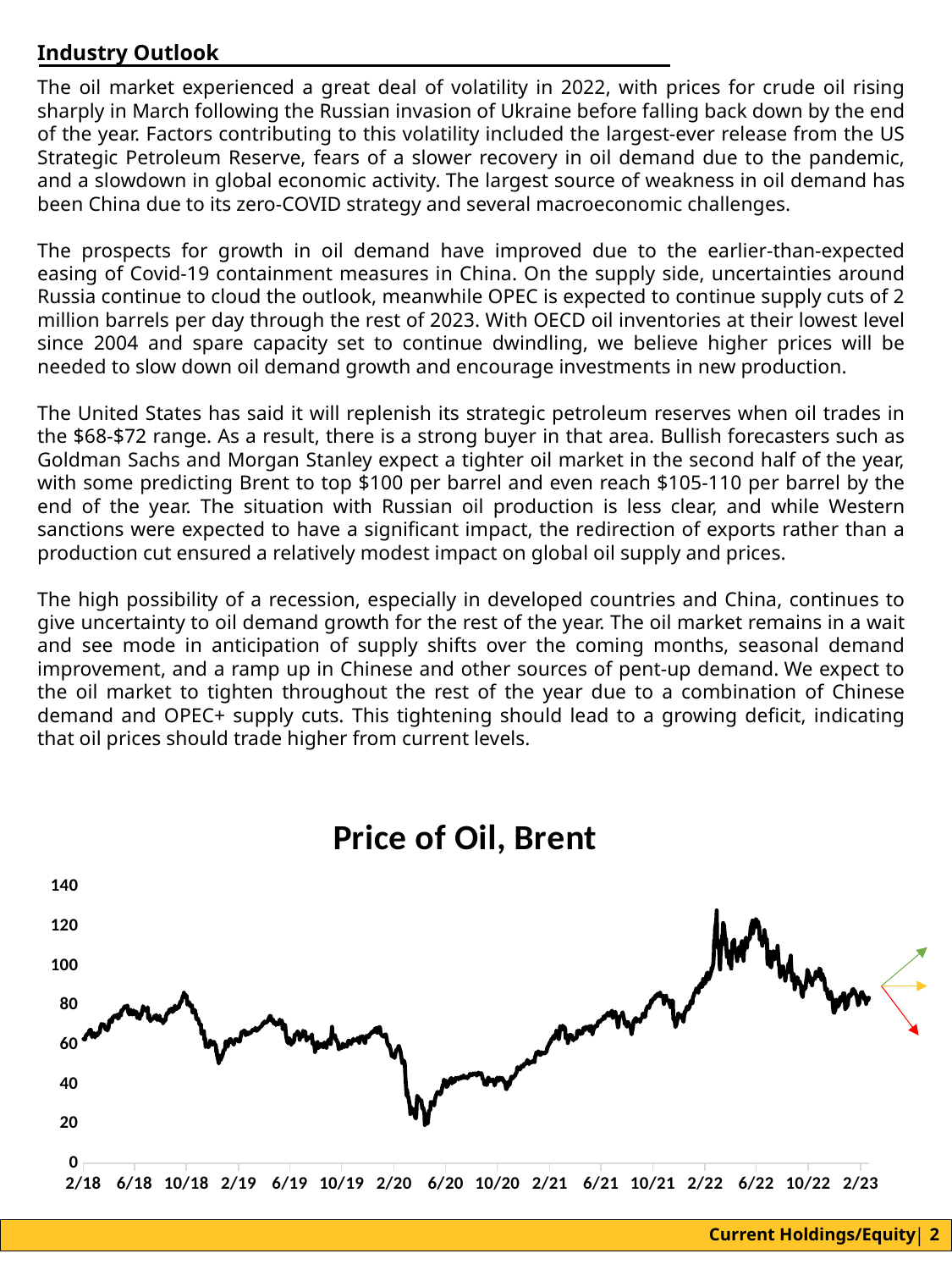
Is the peak value of the Brent oil price in 2022 greater or less than 120? greater In which year does the Brent oil price reach its highest point on the chart? 2022 Is the Brent oil price at 2/23 greater or less than 100? less Does the Brent oil price rise or fall between 6/22 and 2/23? fall Is the Brent oil price at 2/18 greater or less than 40? greater What is the highest value shown on the vertical axis of the chart? 140 How many date labels are shown along the x axis of the chart? 16 What is the title of the chart? Price of Oil, Brent In which year does the Brent oil price reach its lowest point on the chart? 2020 How many lines (series) are plotted on the chart? 1 What kind of chart is shown on the slide? line chart